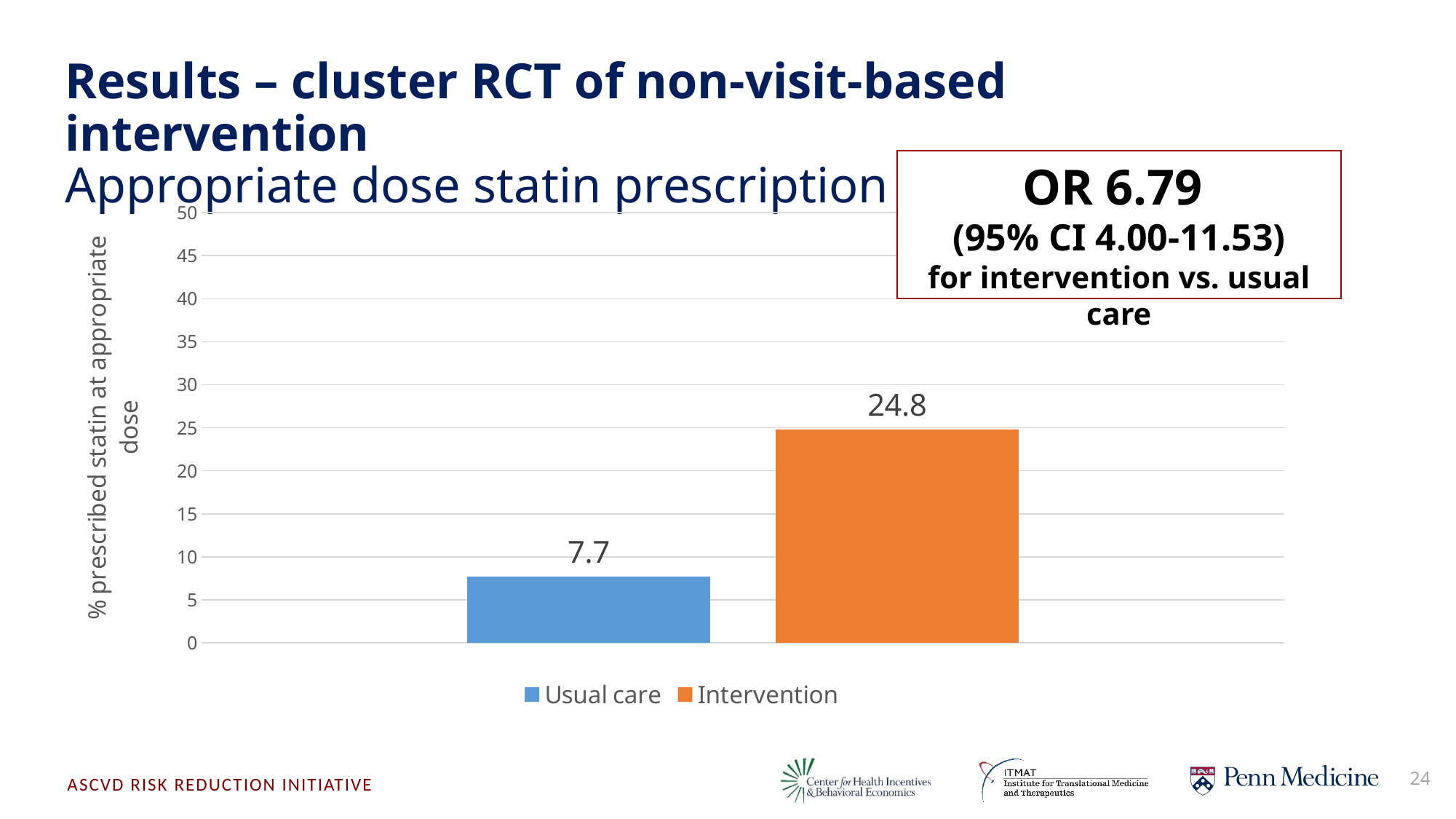
Is the value for Usual care larger or smaller than the value for Intervention? smaller How many bars are plotted in the chart? 2 What is the difference between the Intervention and Usual care values? 17.1 How many series does the legend list? 2 What is the label of the y axis? % prescribed statin at appropriate dose What is the value for Usual care? 7.7 Which group has the higher percentage prescribed statin at appropriate dose? Intervention What kind of chart is shown on the slide? bar chart Is the value for Intervention greater or less than 20? greater Which group has the lower percentage prescribed statin at appropriate dose? Usual care Is the value for Usual care greater or less than 10? less What is the value for Intervention? 24.8